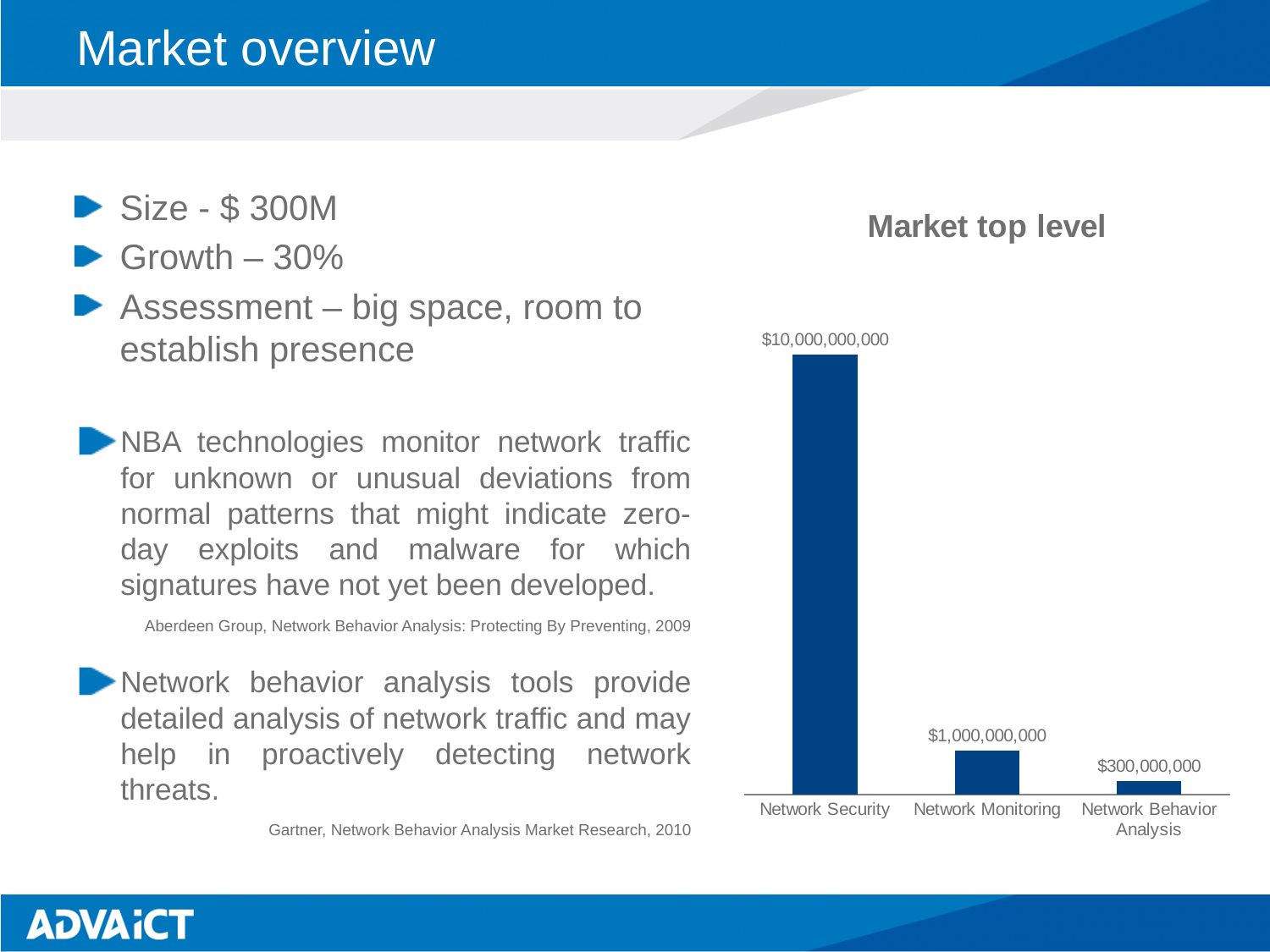
Do the values rise or fall from left to right across the categories in the chart? Fall What is the title of the chart on the slide? Market top level Which category has the lowest value in the Market top level chart? Network Behavior Analysis What is the value for Network Security in the Market top level chart? $10,000,000,000 What is the value for Network Monitoring in the Market top level chart? $1,000,000,000 Which is larger, the value for Network Monitoring or the value for Network Behavior Analysis? Network Monitoring What is the difference between the values for Network Monitoring and Network Behavior Analysis? $700,000,000 What is the value for Network Behavior Analysis in the Market top level chart? $300,000,000 How many categories are shown in the Market top level chart? 3 What kind of chart is shown on the slide? Bar chart What is the difference between the values for Network Security and Network Monitoring? $9,000,000,000 Which category has the highest value in the Market top level chart? Network Security